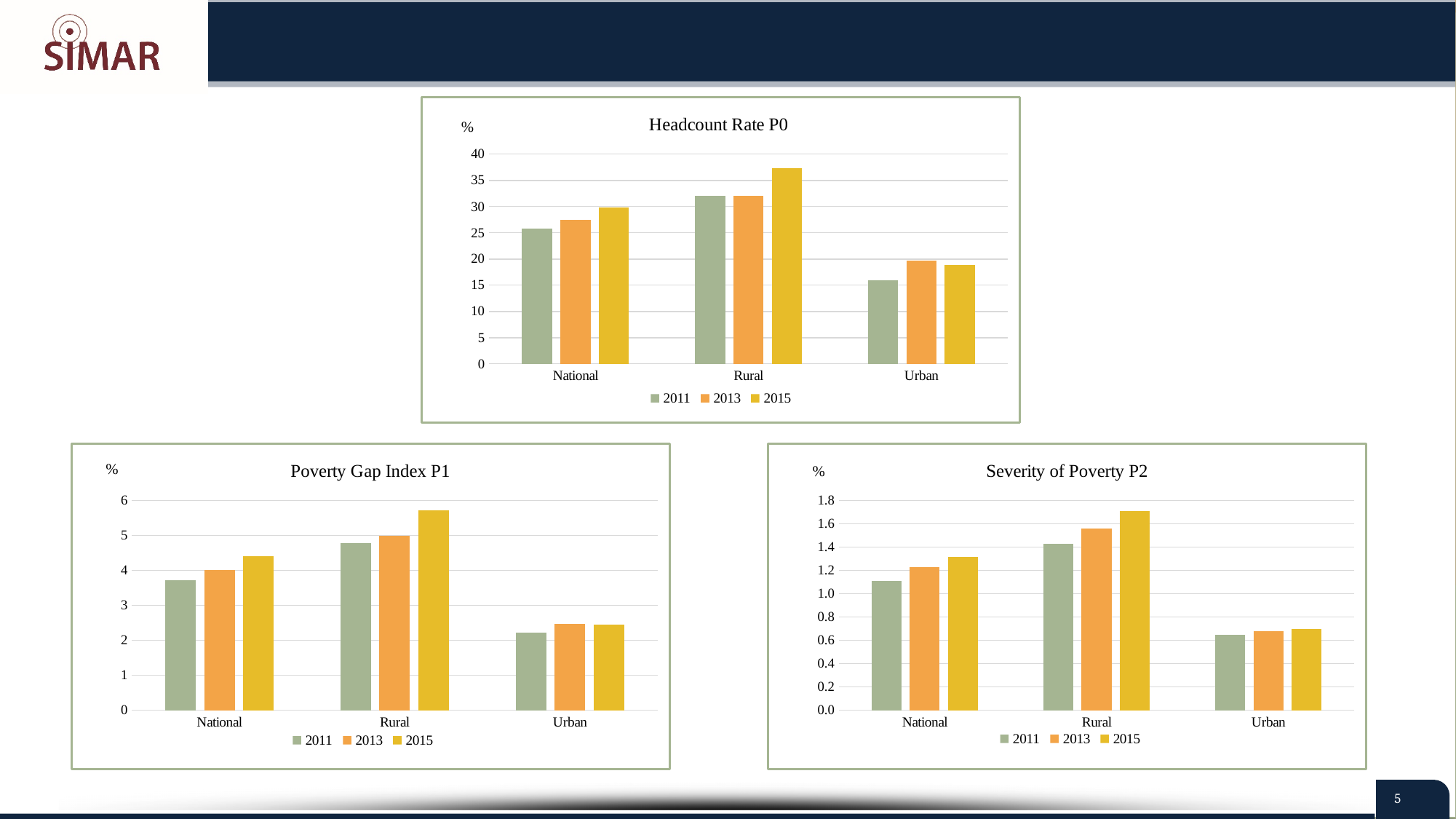
In the Severity of Poverty P2 chart, is the 2013 value for Urban greater or less than 1.0? less In the Severity of Poverty P2 chart, which category has the highest 2013 value? Rural What kind of chart is the Headcount Rate P0 chart? bar chart In the Headcount Rate P0 chart, which is larger: the 2015 value for National or the 2015 value for Urban? National In the Headcount Rate P0 chart, is the 2015 value for Rural greater or less than 35? greater In the Poverty Gap Index P1 chart, is the 2015 value for Rural greater or less than 5? greater How many series does the legend of the Headcount Rate P0 chart list? 3 In the Poverty Gap Index P1 chart, which category has the lowest 2011 value? Urban How many categories are shown on the x axis of the Headcount Rate P0 chart? 3 In the Poverty Gap Index P1 chart, do the National values rise or fall from 2011 to 2015? rise In the Headcount Rate P0 chart, which category has the highest 2015 value? Rural